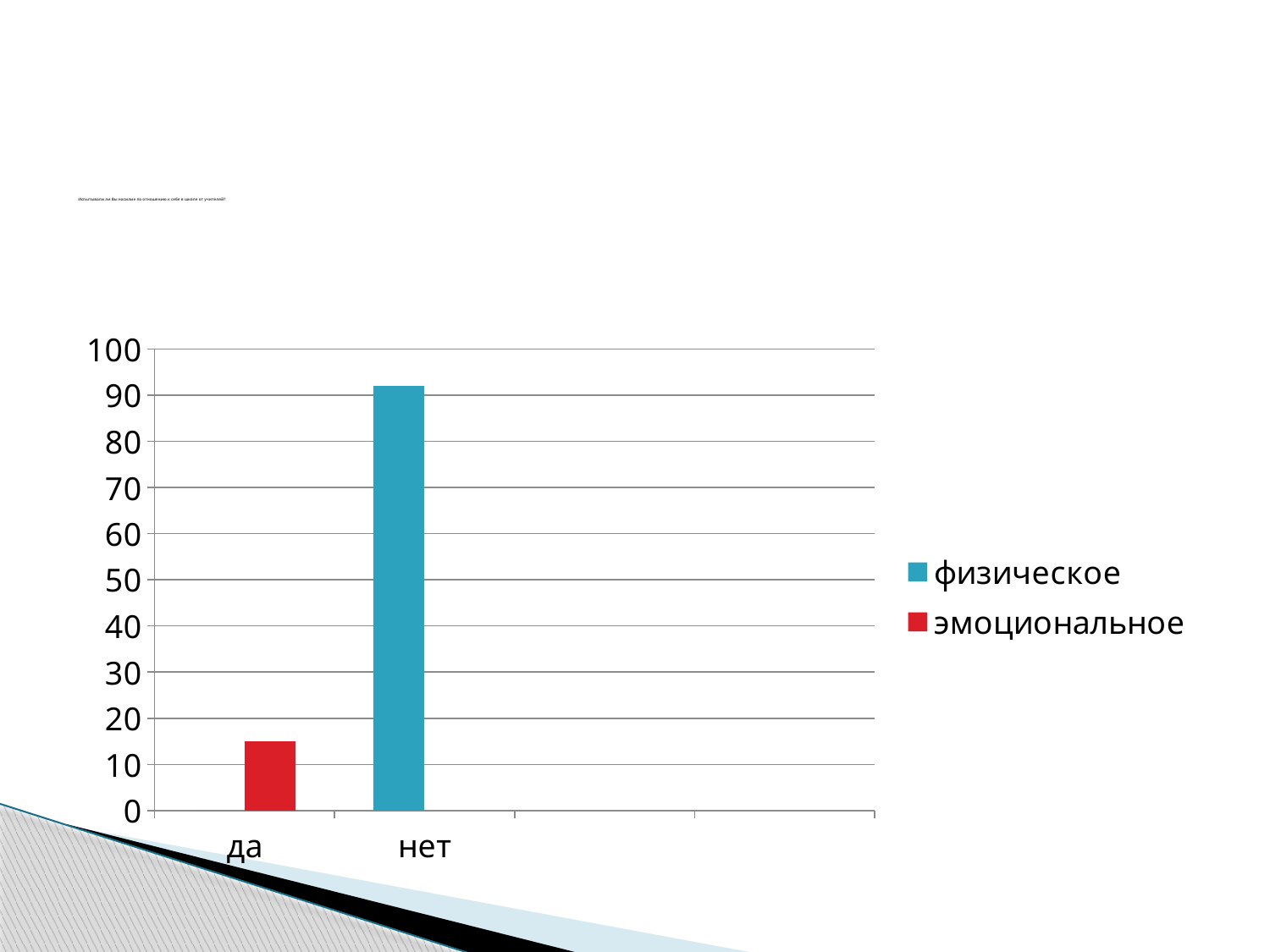
Is the value for "да" greater or less than 10? greater Which category has the tallest bar? нет Which category has the shortest bar? да Which series is plotted for the category "да"? эмоциональное Which is larger, the bar for "да" or the bar for "нет"? нет What kind of chart is shown on the slide? bar chart How many series does the legend list? 2 What colour represents the series "физическое" in the legend? blue How many labelled categories are shown on the x axis? 2 Is the value for "нет" greater or less than 80? greater Is the value for "да" greater or less than 20? less